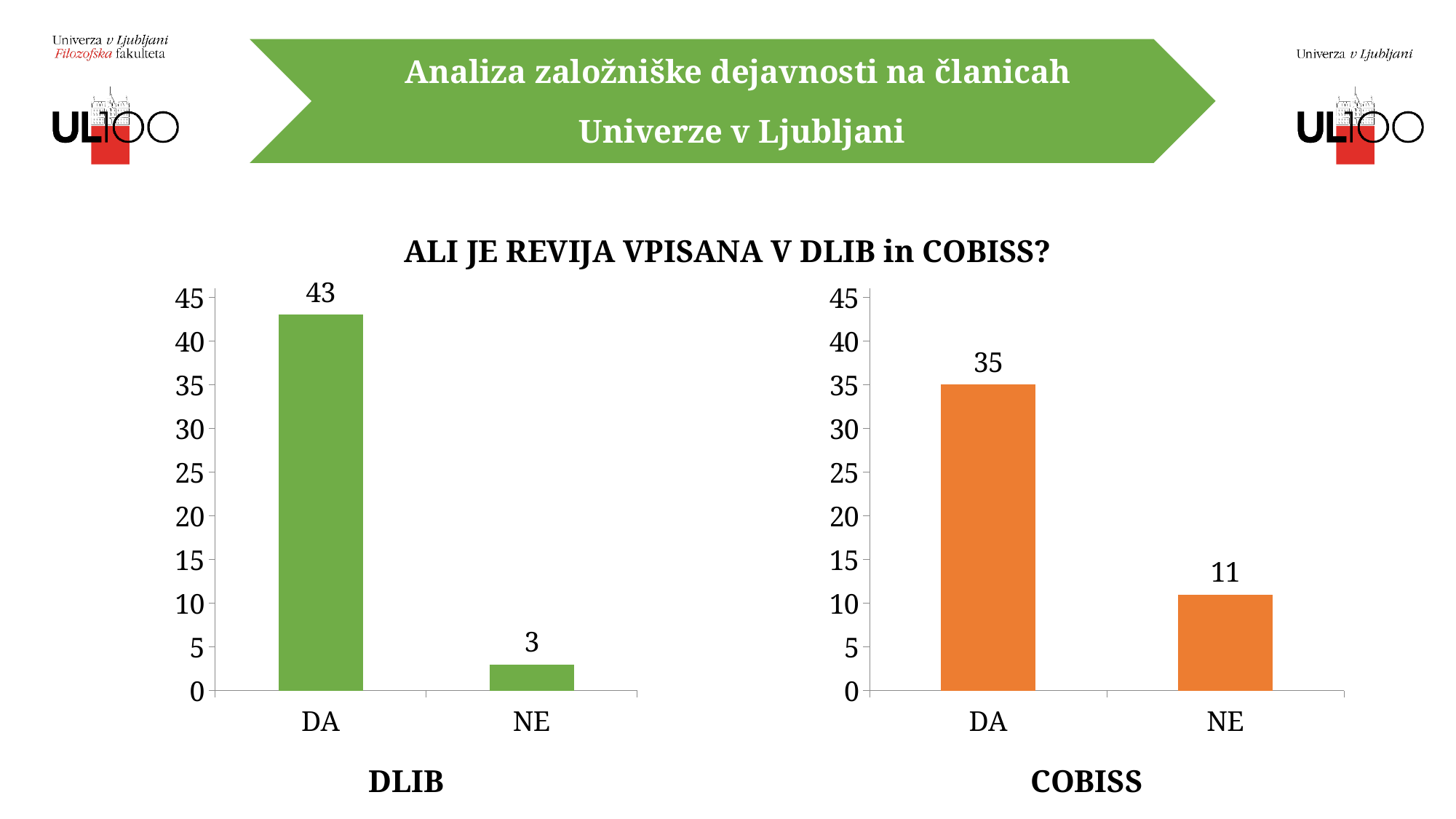
In the COBISS chart, what is the value for DA? 35 In the COBISS chart, which category has the lowest value? NE In the DLIB chart, what is the value for NE? 3 What kind of chart is the DLIB chart? Bar chart How many categories are shown in the COBISS chart? 2 In the DLIB chart, what is the difference between the DA and NE values? 40 What colour are the bars in the COBISS chart? Orange In the COBISS chart, what is the difference between the DA and NE values? 24 In the DLIB chart, what is the value for DA? 43 In the DLIB chart, which category has the highest value? DA In the COBISS chart, what is the value for NE? 11 Which is larger: the DA value in the DLIB chart or the DA value in the COBISS chart? DLIB